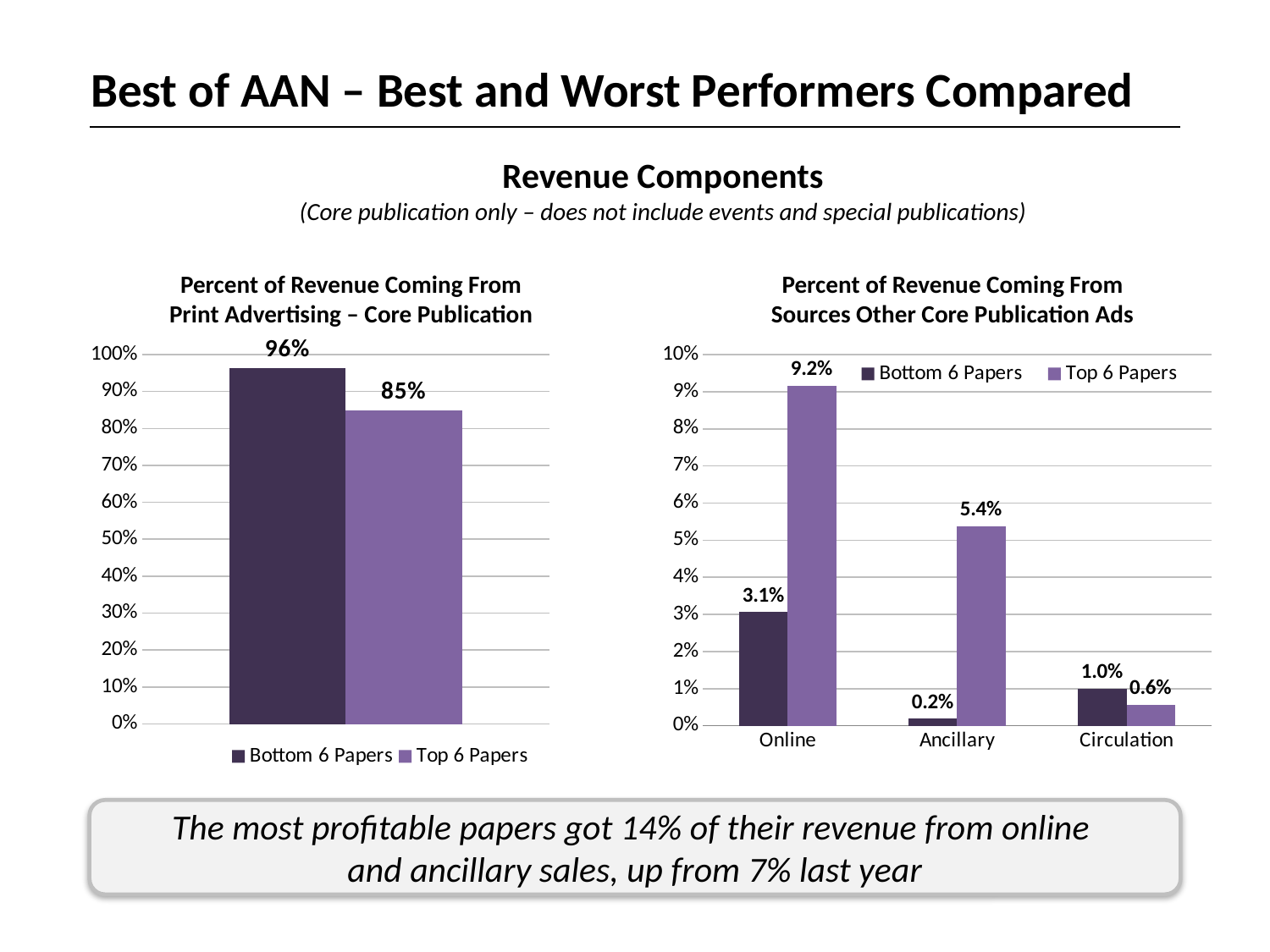
How many categories are shown on the x axis of the right chart (Percent of Revenue Coming From Sources Other Core Publication Ads)? 3 In the right chart (Percent of Revenue Coming From Sources Other Core Publication Ads), what is the Ancillary value for Bottom 6 Papers? 0.2% In the left chart (Percent of Revenue Coming From Print Advertising – Core Publication), what is the difference between the Bottom 6 Papers and Top 6 Papers values? 11% In the right chart (Percent of Revenue Coming From Sources Other Core Publication Ads), what is the Circulation value for Top 6 Papers? 0.6% In the right chart (Percent of Revenue Coming From Sources Other Core Publication Ads), what is the Online value for Top 6 Papers? 9.2% In the left chart (Percent of Revenue Coming From Print Advertising – Core Publication), which series has the larger value, Bottom 6 Papers or Top 6 Papers? Bottom 6 Papers In the right chart (Percent of Revenue Coming From Sources Other Core Publication Ads), what is the difference between the Top 6 Papers and Bottom 6 Papers values for Online? 6.1% In the right chart (Percent of Revenue Coming From Sources Other Core Publication Ads), which category has the highest value for Top 6 Papers? Online What kind of chart is the left chart (Percent of Revenue Coming From Print Advertising – Core Publication)? Bar chart In the left chart (Percent of Revenue Coming From Print Advertising – Core Publication), what is the value for Top 6 Papers? 85% In the left chart (Percent of Revenue Coming From Print Advertising – Core Publication), what is the value for Bottom 6 Papers? 96% In the right chart (Percent of Revenue Coming From Sources Other Core Publication Ads), which category has the lowest value for Bottom 6 Papers? Ancillary